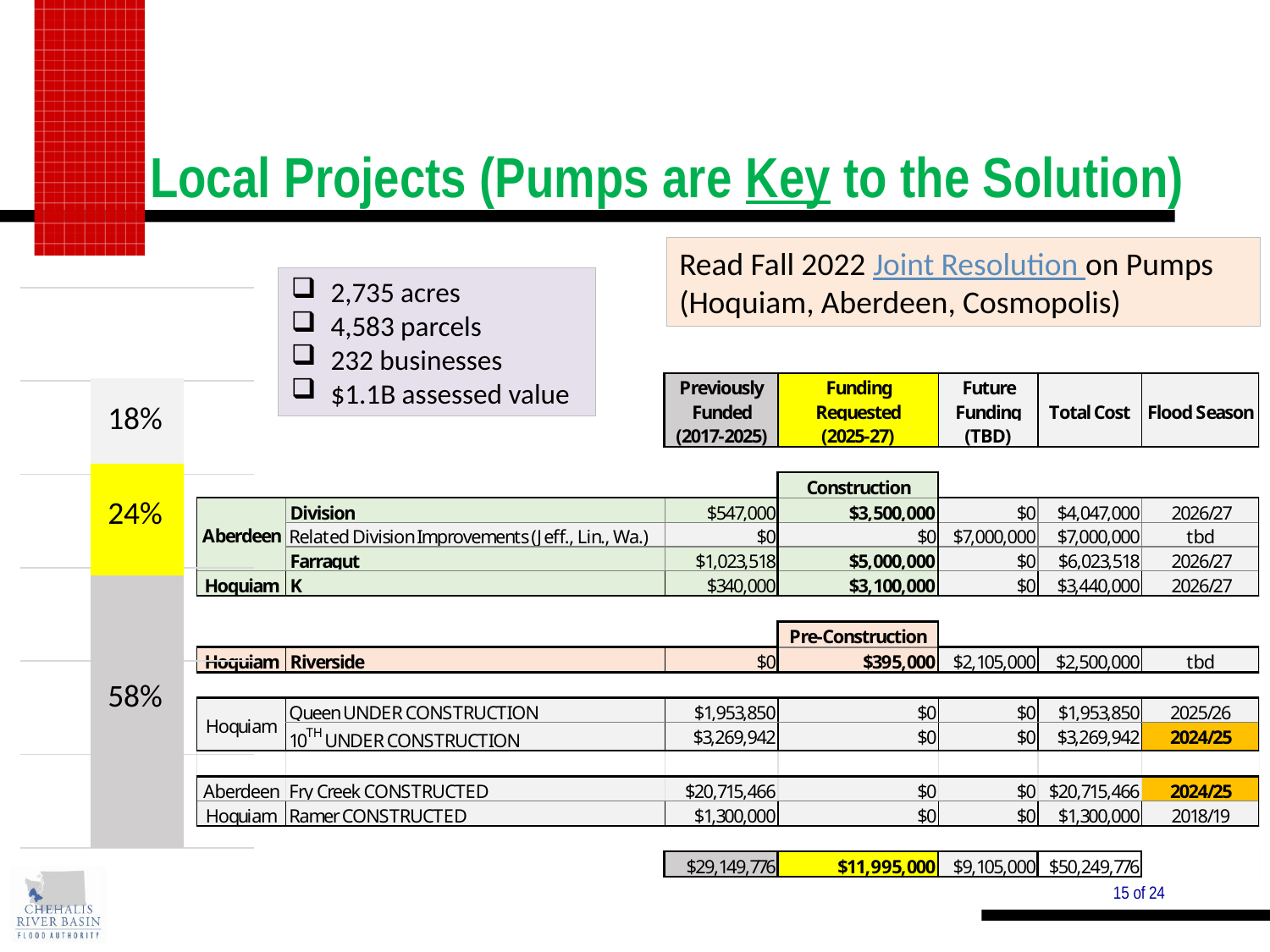
How many segments does the stacked bar on the left of the slide have? 3 What kind of chart is shown on the left side of the slide? stacked bar chart Which segment of the stacked bar has the smallest value? 18% What value is labelled on the yellow segment of the stacked bar? 24% Which segment of the stacked bar has the largest value? 58% What is the difference between the yellow segment (24%) and the top segment (18%) of the stacked bar? 6% What colour is the 24% segment of the stacked bar? yellow What is the total of the three segments in the stacked bar? 100% Which is larger in the stacked bar: the yellow segment or the top segment? the yellow segment (24%) What is the difference between the bottom segment (58%) and the yellow segment (24%) of the stacked bar? 34% What value is labelled on the bottom (gray) segment of the stacked bar? 58% What value is labelled on the top segment of the stacked bar? 18%